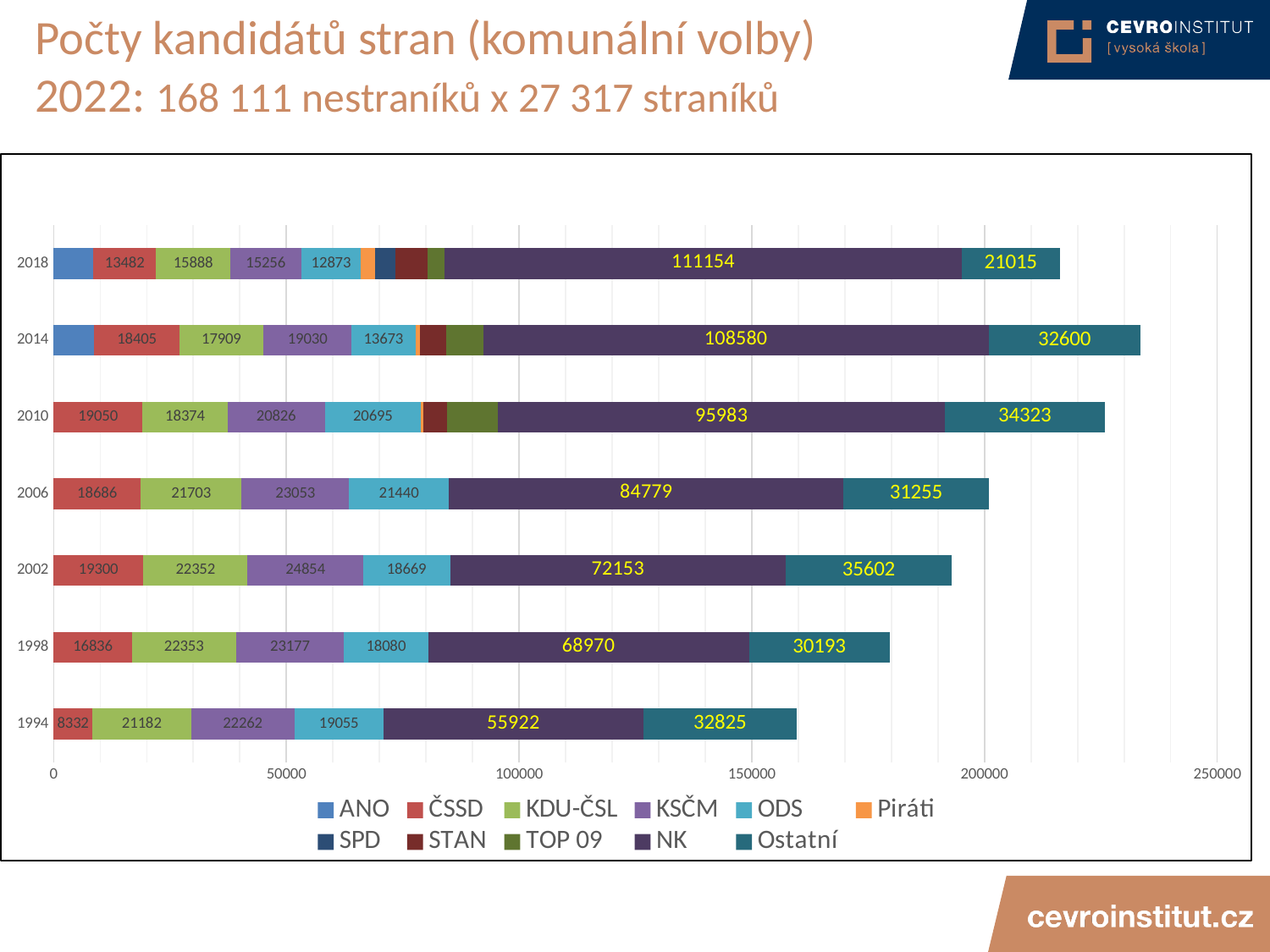
In which year is the Ostatní value lowest? 2018 How many series does the legend list? 11 What is the value for KSČM in 2002? 24854 What is the value for ČSSD in 2010? 19050 What is the value for Ostatní in 2014? 32600 Is the total length of the 2014 bar greater or less than 200000? greater What kind of chart is shown on the slide? Stacked bar chart What is the difference between the NK values for 2018 and 2014? 2574 Which is larger in 2006, the KSČM value or the ODS value? KSČM How many years are shown on the chart? 7 What is the value for NK in 2018? 111154 In which year is the NK value highest? 2018